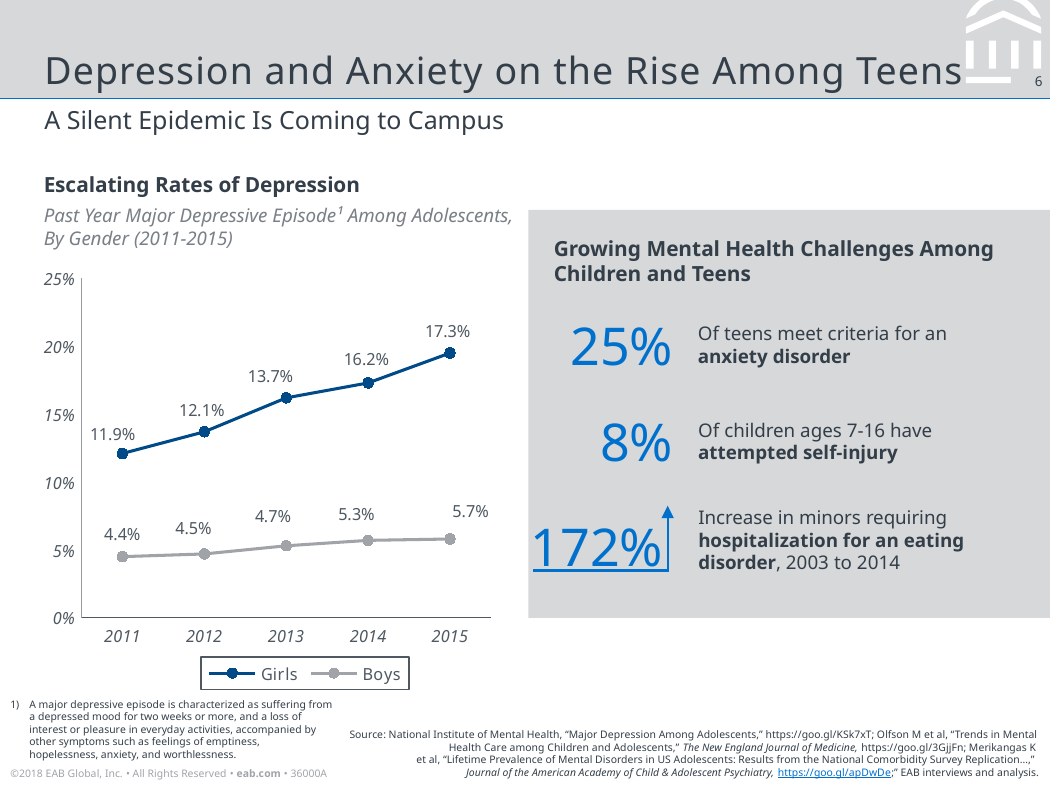
What was the rate of past year major depressive episode among girls in 2015? 17.3% What was the rate for boys in 2011? 4.4% In which year was the rate for girls highest? 2015 Which was higher in 2012, the rate for girls or for boys? Girls Do the rates for girls rise or fall from 2011 to 2015? Rise What was the rate for girls in 2013? 13.7% How many series does the legend list? 2 In which year was the rate for boys lowest? 2011 By how much did the girls' rate increase from 2011 to 2015? 5.4% What is the difference between the girls' and boys' rates in 2015? 11.6% What kind of chart is shown? Line chart How many years are plotted on the x axis? 5